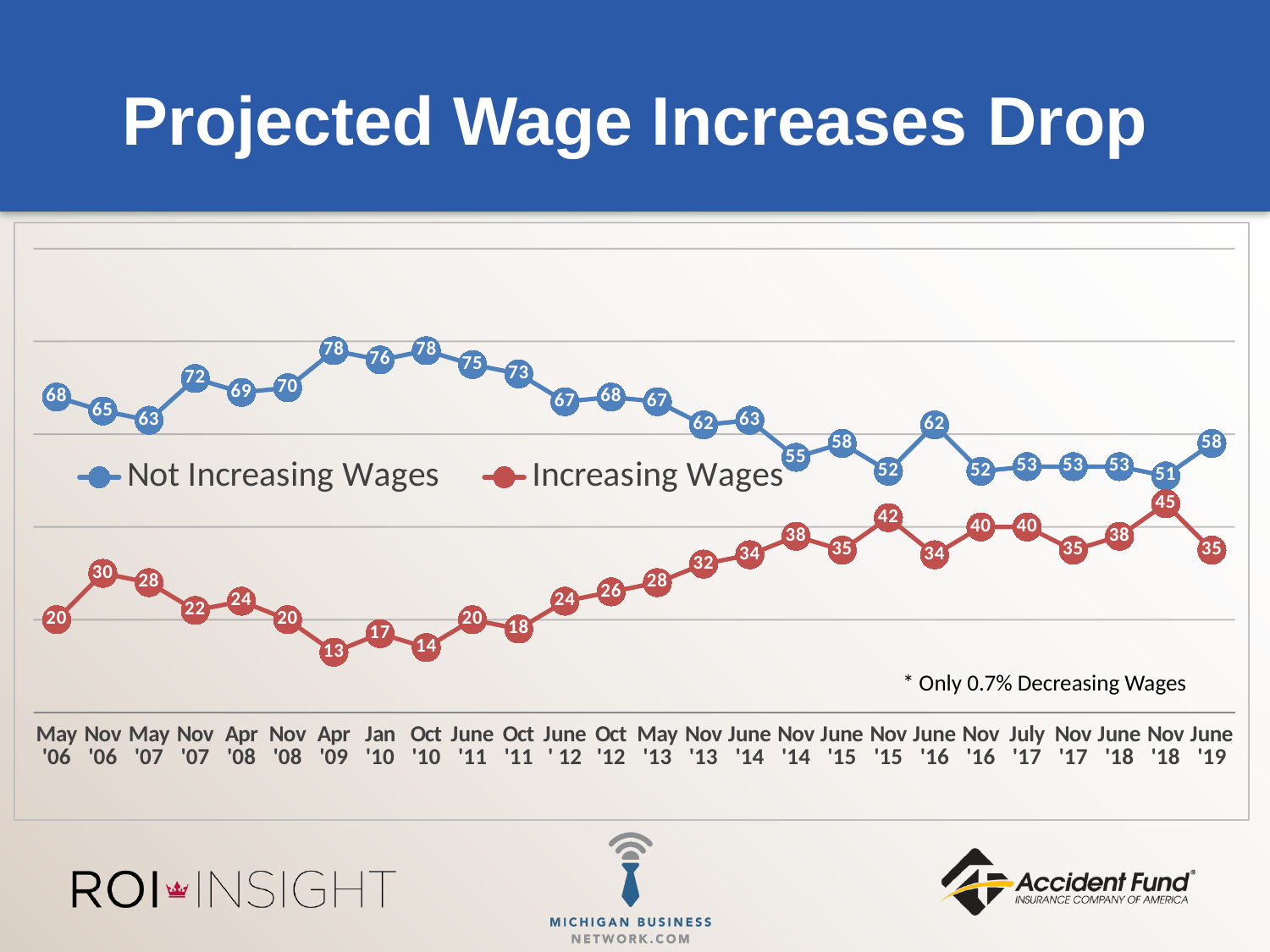
Does the Not Increasing Wages series generally rise or fall from Oct '10 to Nov '18? Fall In which period is the Increasing Wages value highest? Nov '18 How many series does the legend list? 2 What is the value for Increasing Wages in June '19? 35 In which period is the Increasing Wages value lowest? Apr '09 What is the value for Increasing Wages in Nov '18? 45 What kind of chart is shown on the slide? Line chart How many time periods are plotted on the x axis? 26 What is the value for Not Increasing Wages in May '06? 68 In which period is the Not Increasing Wages value lowest? Nov '18 What is the difference between the Not Increasing Wages values in June '19 and Nov '18? 7 In June '19, which series has the larger value, Not Increasing Wages or Increasing Wages? Not Increasing Wages